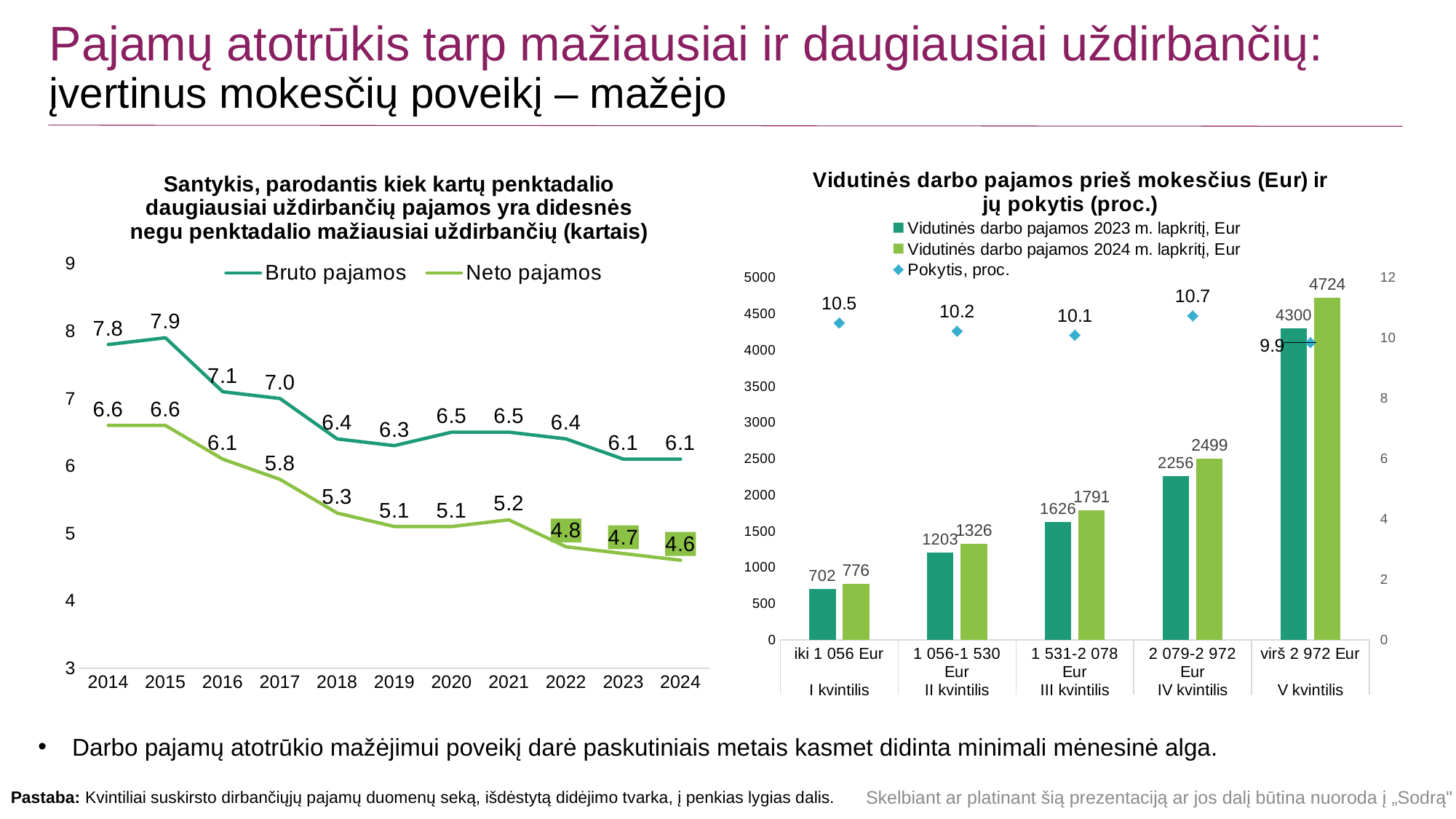
In the left chart (Santykis...), what is the Neto pajamos value for 2024? 4.6 In the right chart (Vidutinės darbo pajamos...), what is the Vidutinės darbo pajamos 2024 m. lapkritį value for III kvintilis? 1791 In the left chart (Santykis...), do the Bruto pajamos values generally rise or fall from 2014 to 2024? fall In the right chart (Vidutinės darbo pajamos...), what is the difference between the 2024 and 2023 values for V kvintilis? 424 In the left chart (Santykis...), how many years are shown on the x axis? 11 In the right chart (Vidutinės darbo pajamos...), how many series does the legend list? 3 In the right chart (Vidutinės darbo pajamos...), what is the Pokytis, proc. value for IV kvintilis? 10.7 In the right chart (Vidutinės darbo pajamos...), which quintile has the lowest Pokytis, proc. value? V kvintilis In the left chart (Santykis...), how many series does the legend list? 2 In the left chart (Santykis...), which year has the lowest Neto pajamos value? 2024 In the left chart (Santykis...), what is the difference between Bruto pajamos and Neto pajamos in 2018? 1.1 In the left chart (Santykis...), what is the Bruto pajamos value for 2015? 7.9